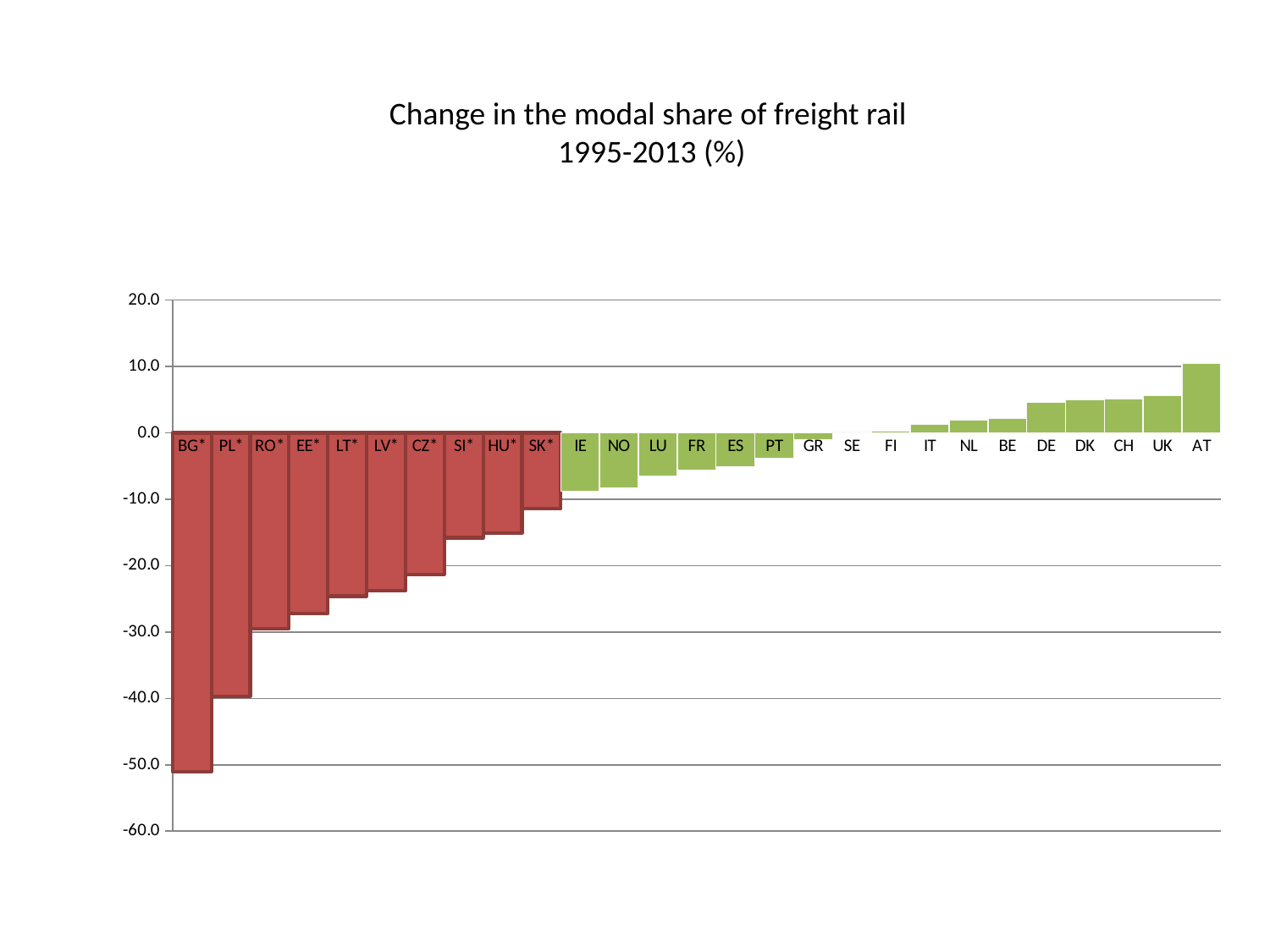
Which country has the lowest value in the chart? BG* Is the value for SK* greater or less than -10.0? less Which has the larger value, LT* or HU*? HU* What kind of chart is shown on the slide? bar chart What is the title of the chart? Change in the modal share of freight rail 1995-2013 (%) How many countries are shown on the x axis of the chart? 27 Which country has the highest value in the chart? AT Is the value for UK greater or less than 10.0? less Do the values rise or fall moving from left to right along the x axis? rise Is the value for BG* greater or less than -50.0? less